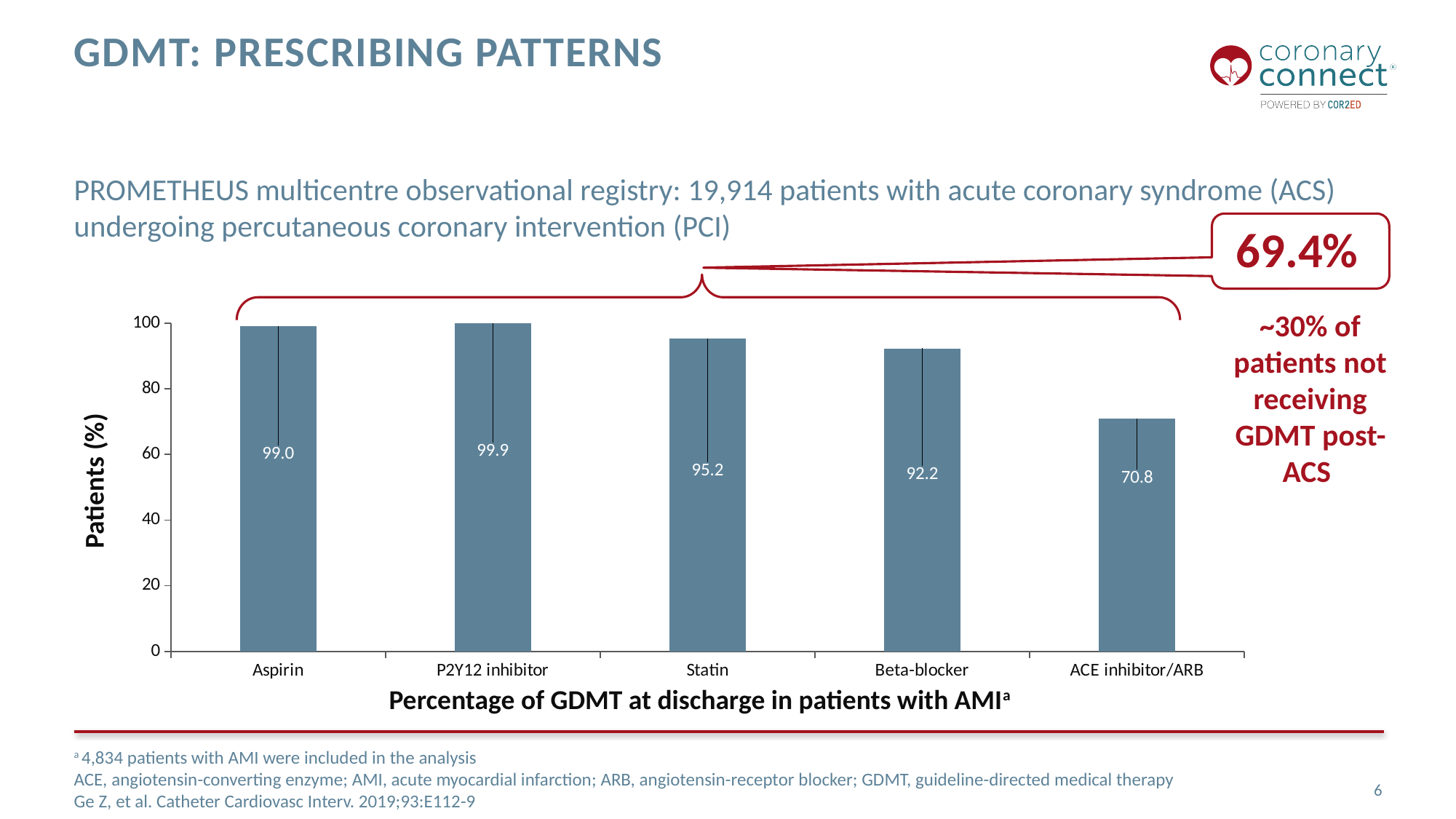
What percentage of patients received aspirin at discharge? 99.0 Which medication has the highest percentage of patients? P2Y12 inhibitor What kind of chart is shown on the slide? Bar chart Is the value for ACE inhibitor/ARB greater or less than 80? less How many medication categories are shown on the x axis? 5 Which is larger, the value for Statin or the value for Beta-blocker? Statin What is the value shown for Beta-blocker? 92.2 What is the label of the y axis? Patients (%) What is the difference between the P2Y12 inhibitor value and the ACE inhibitor/ARB value? 29.1 What is the difference between the Statin value and the Beta-blocker value? 3.0 Which medication has the lowest percentage of patients? ACE inhibitor/ARB What is the value shown for ACE inhibitor/ARB? 70.8